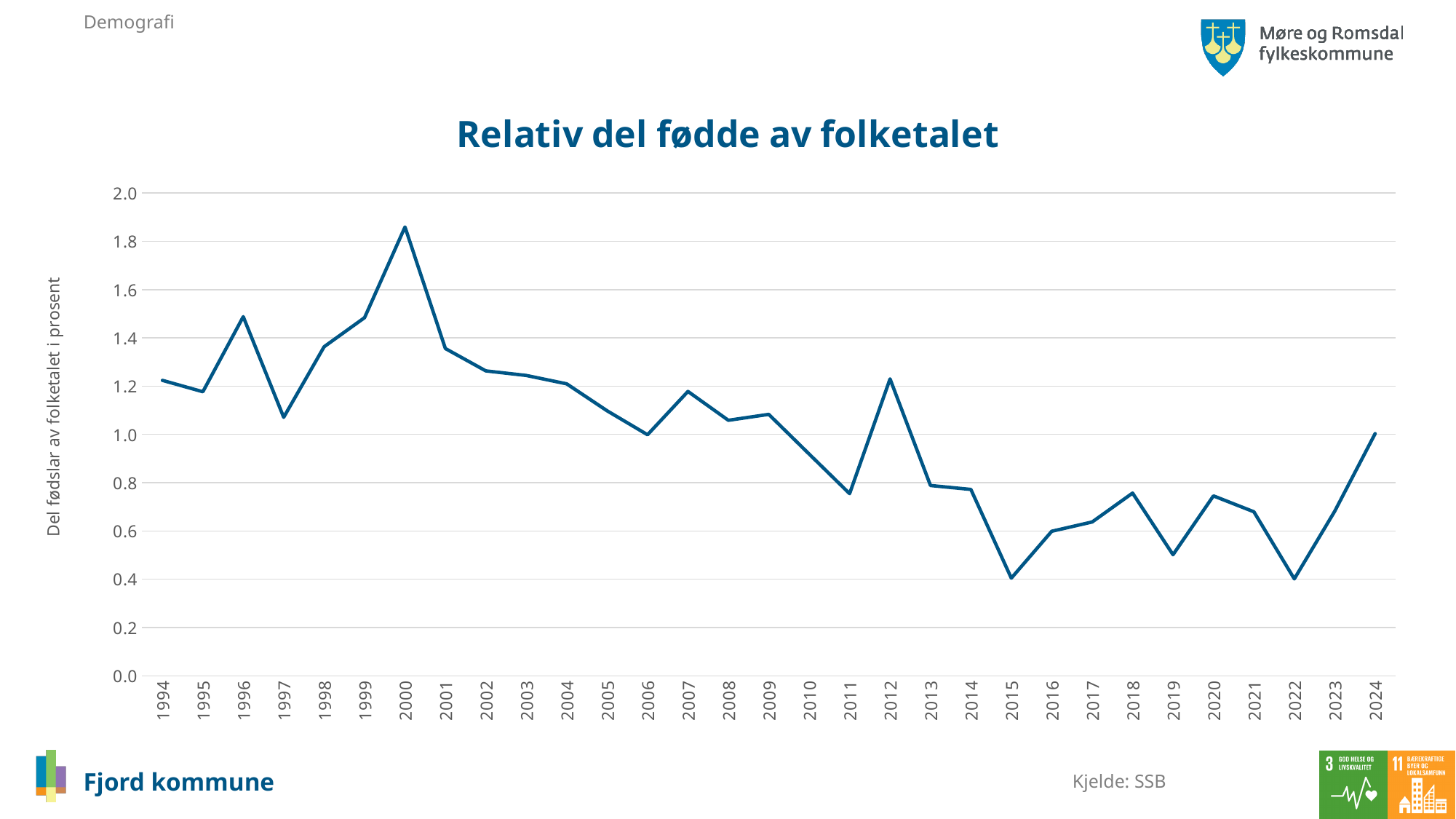
Which year has the larger value, 2012 or 2013? 2012 How many years are shown along the x axis? 31 Which year has the larger value, 1996 or 1997? 1996 What kind of chart is shown on the slide? line chart Is the value for 2016 greater or less than 0.8? less What is the title of the chart? Relativ del fødde av folketalet Is the value for 2011 greater or less than 0.8? less Is the value for 2000 greater or less than 1.8? greater Does the line generally rise or fall from 2000 to 2022? fall In which year does the line reach its highest value? 2000 What is the label on the vertical axis of the chart? Del fødslar av folketalet i prosent